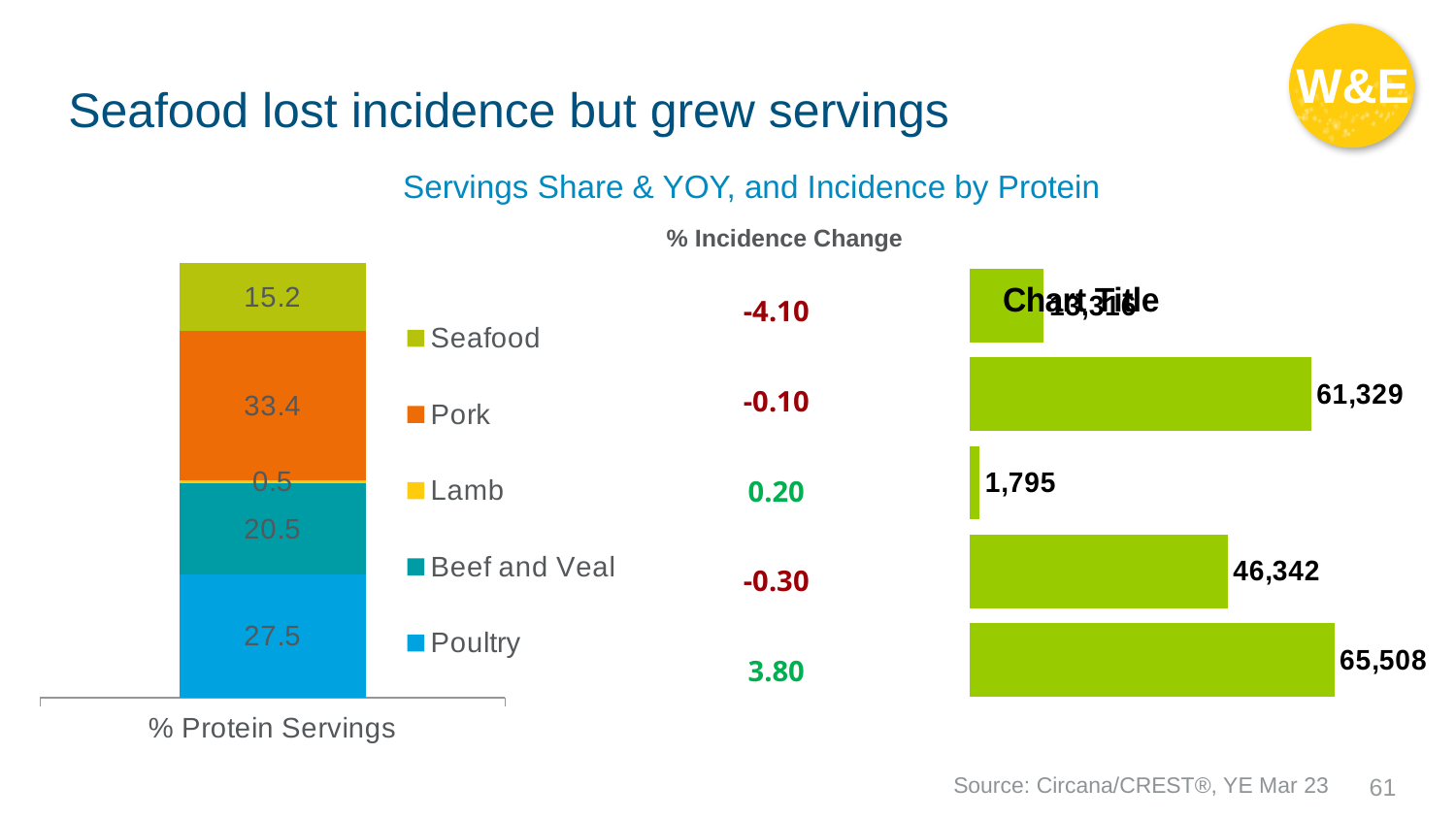
In the stacked bar chart on the left (% Protein Servings), which is larger, Beef and Veal or Poultry? Poultry In the horizontal bar chart on the right, what is the value of the second bar from the top? 61,329 In the horizontal bar chart on the right, what is the smallest value shown? 1,795 In the stacked bar chart on the left (% Protein Servings), how much larger is the Pork value than the Seafood value? 18.2 In the stacked bar chart on the left (% Protein Servings), what is the total of all the segments? 97.1 How many series does the legend of the stacked bar chart on the left list? 5 In the stacked bar chart on the left (% Protein Servings), which protein has the largest share? Pork In the horizontal bar chart on the right, what is the largest value shown? 65,508 In the stacked bar chart on the left (% Protein Servings), which protein has the smallest share? Lamb In the stacked bar chart on the left (% Protein Servings), what is the value for Poultry? 27.5 What kind of chart is the chart on the left (% Protein Servings)? Stacked bar chart In the stacked bar chart on the left (% Protein Servings), what is the value for Pork? 33.4